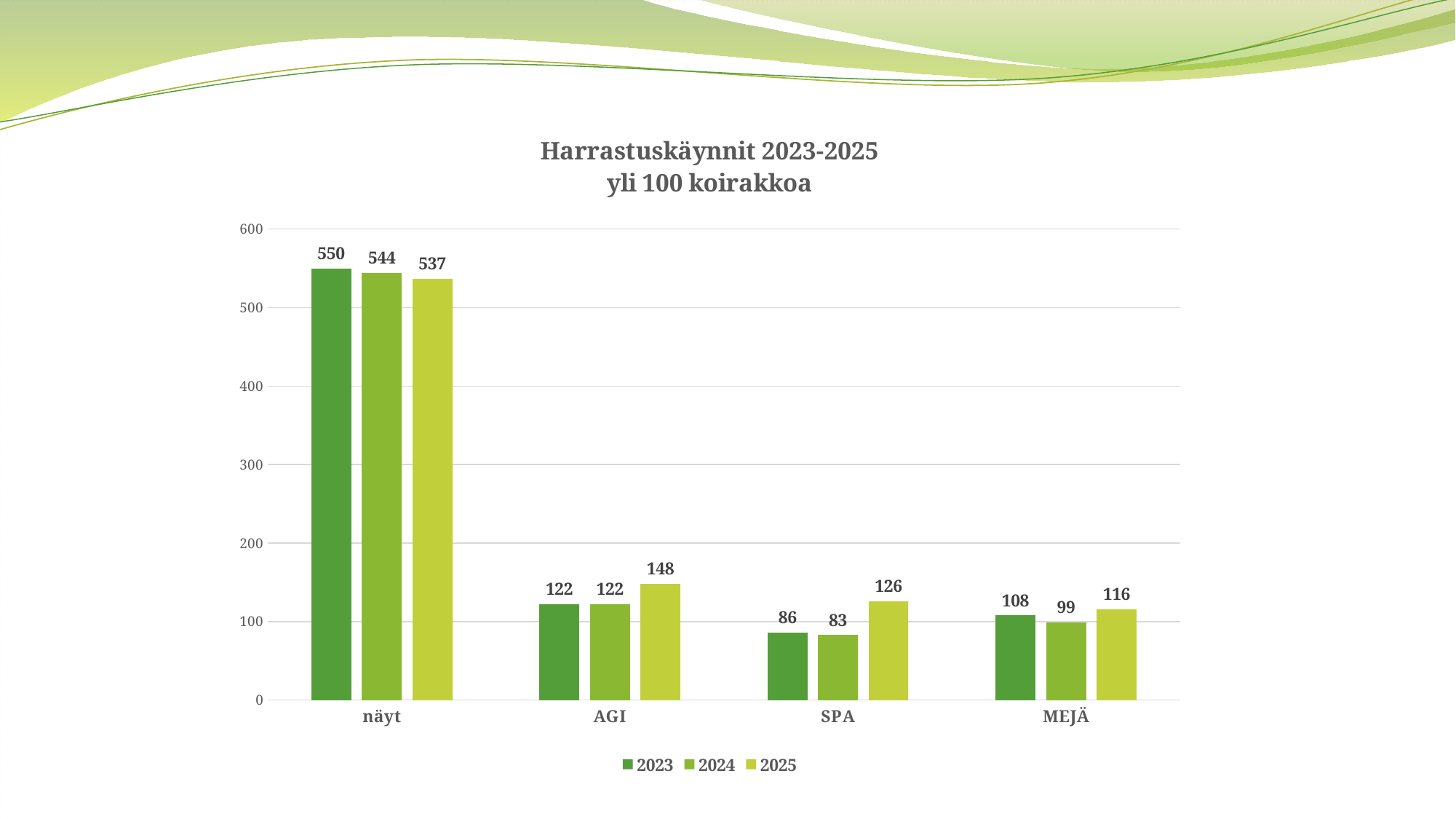
What is the difference between the 2025 and 2024 values for AGI? 26 What is the difference between the 2023 and 2025 values for näyt? 13 What is the value for MEJÄ in 2024? 99 What kind of chart is shown on the slide? bar chart How many series does the legend list? 3 What is the value for näyt in 2023? 550 Which is larger for MEJÄ: the 2023 value or the 2025 value? 2025 How many categories are shown on the x axis? 4 What is the title of the chart? Harrastuskäynnit 2023-2025 yli 100 koirakkoa What is the value for SPA in 2025? 126 Which category has the lowest value in 2024? SPA Which category has the highest value in 2025? näyt